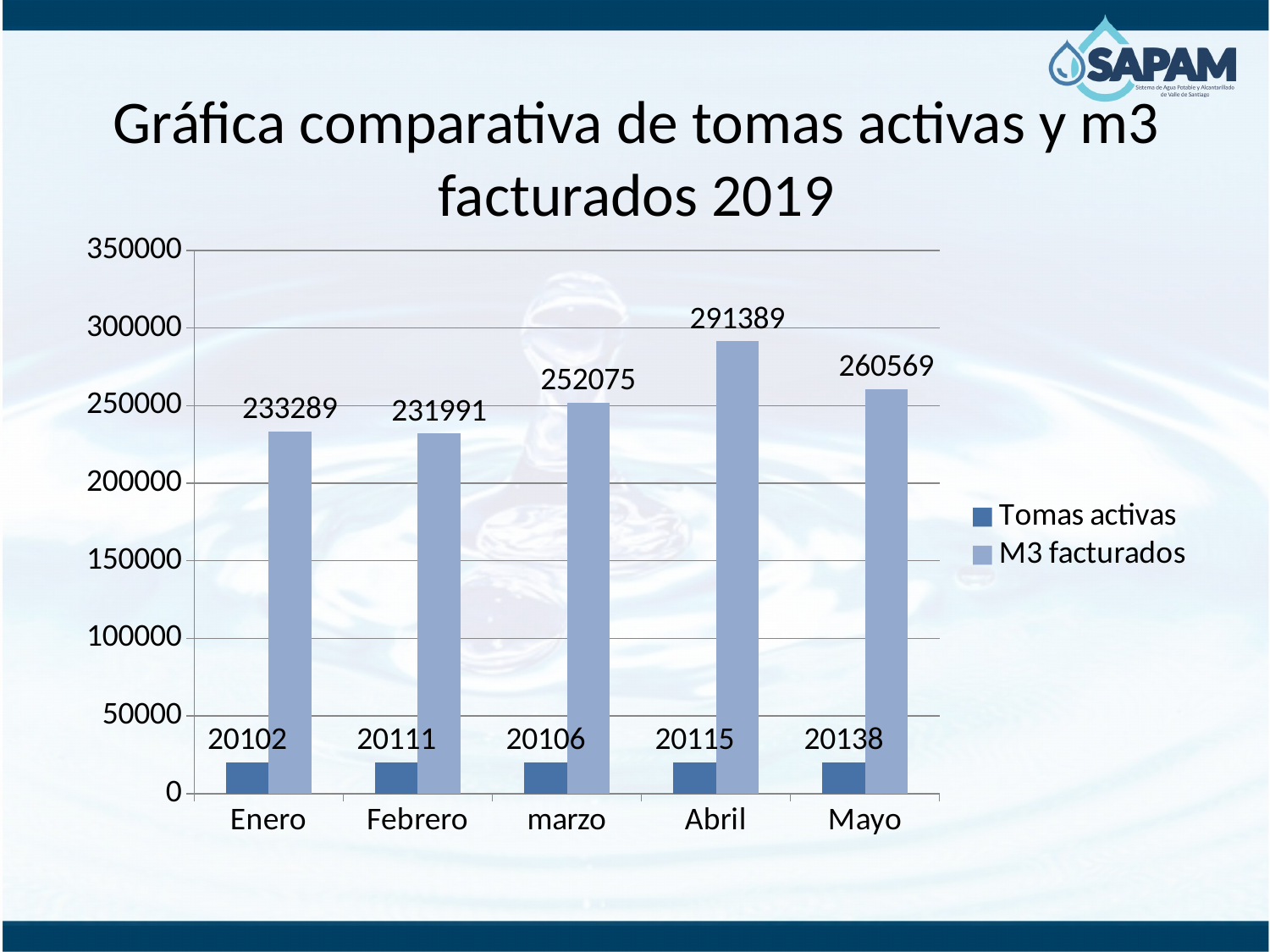
How many series does the legend list? 2 Which month has the lowest value of M3 facturados? Febrero What is the difference between M3 facturados in Abril and in Enero? 58100 What kind of chart is shown on the slide? bar chart What is the value of M3 facturados for Abril? 291389 What is the difference between Tomas activas in Mayo and in Febrero? 27 Is the value of M3 facturados for Enero greater or less than 200000? greater Which month has the highest value of M3 facturados? Abril What is the value of M3 facturados for Febrero? 231991 Which is larger, M3 facturados in marzo or in Mayo? Mayo What is the value of Tomas activas for Mayo? 20138 How many months are shown on the x axis? 5